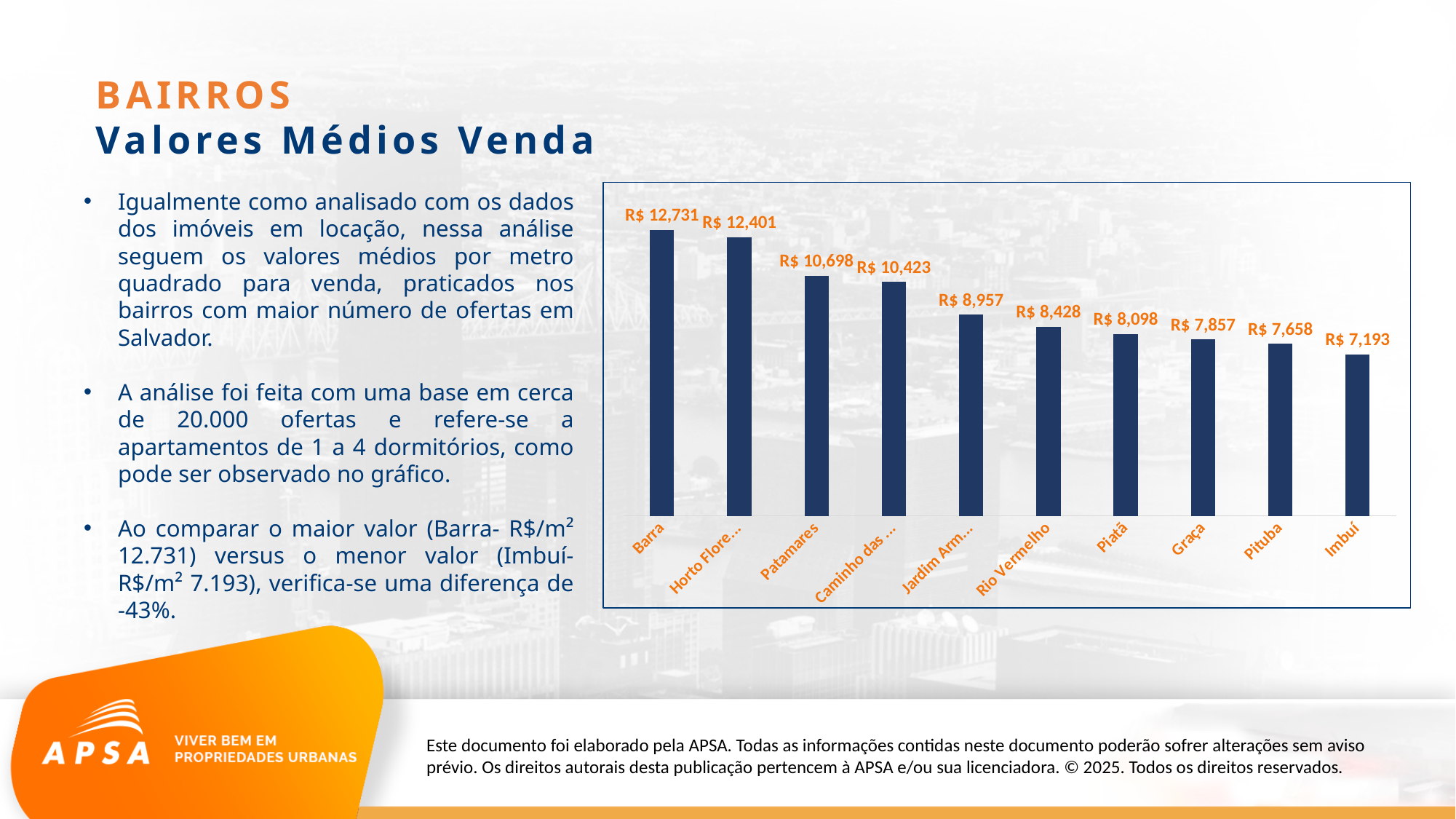
What is the value shown for Imbuí? R$ 7,193 Which has a larger value, Graça or Pituba? Graça How many bairros (categories) are plotted in the chart? 10 What type of chart is shown on the slide? Bar chart Do the values rise or fall from left to right across the chart? Fall Which bairro has the highest value in the chart? Barra What is the value shown for Barra? R$ 12,731 What is the value shown for Rio Vermelho? R$ 8,428 What is the difference between the values for Barra and Imbuí? R$ 5,538 What is the value shown for Patamares? R$ 10,698 Which bairro has the lowest value in the chart? Imbuí What is the value shown for Pituba? R$ 7,658